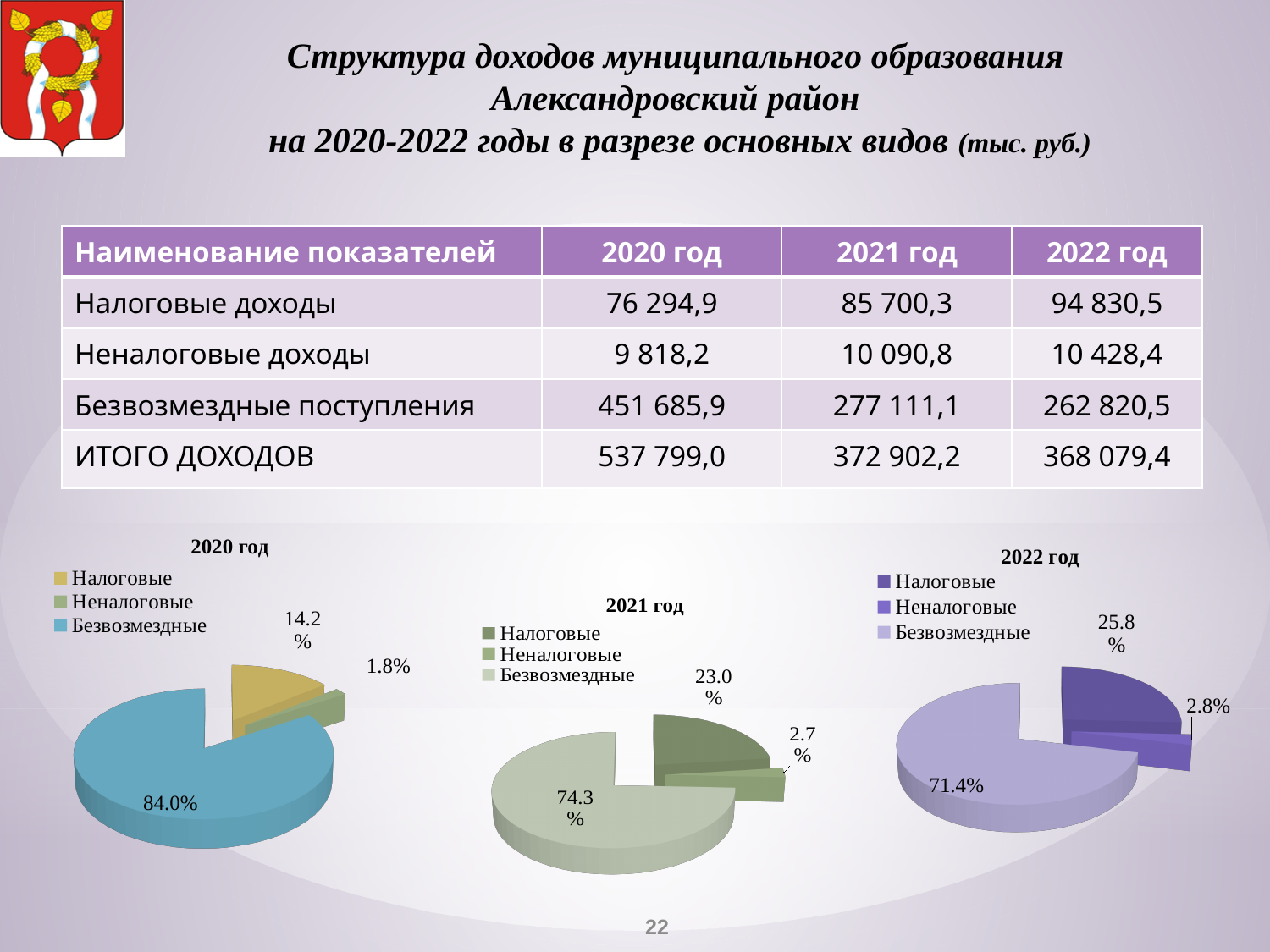
What kind of chart is the "2020 год" chart? pie chart How many slices does the "2022 год" pie chart have? 3 In the "2022 год" pie chart, which category has the largest slice? Безвозмездные In the "2020 год" pie chart, which is larger: the Налоговые slice or the Неналоговые slice? Налоговые In the "2020 год" pie chart, what share is labelled for Безвозмездные? 84.0% In the "2021 год" pie chart, what share is labelled for Неналоговые? 2.7% In the "2022 год" pie chart, what share is labelled for Налоговые? 25.8% In the "2021 год" pie chart, which category has the smallest slice? Неналоговые In the "2022 год" pie chart, what is the difference between the Безвозмездные share and the Налоговые share? 45.6% How many entries does the legend of the "2021 год" pie chart list? 3